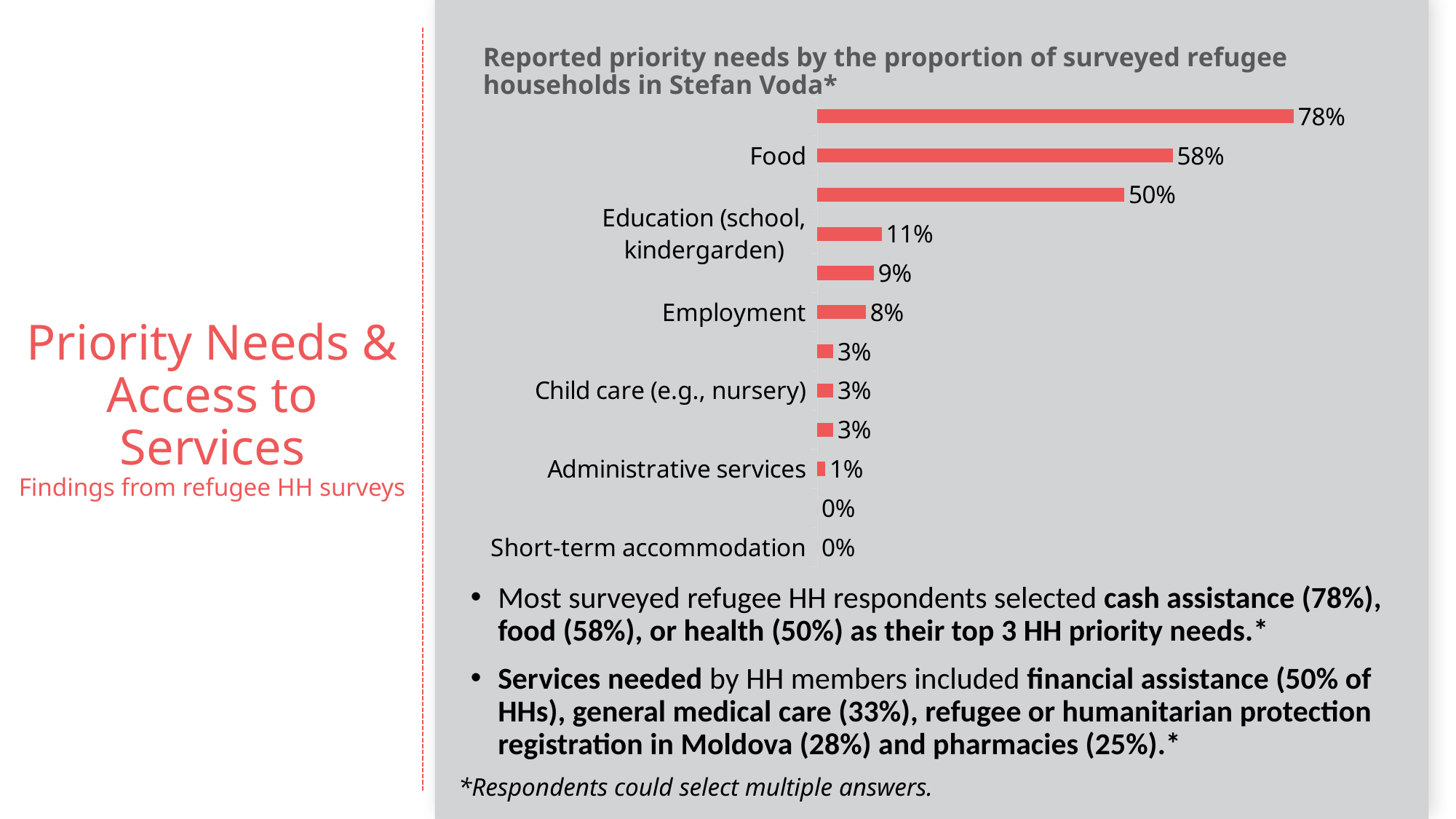
What is the value for Child care (e.g., nursery)? 3% What is the value for Administrative services? 1% What is the value for Education (school, kindergarden)? 11% How many bars (categories) are plotted in the chart? 12 What proportion of households reported Employment as a priority need? 8% What is the difference between the values for Food and Education (school, kindergarden)? 47 percentage points What proportion of surveyed refugee households reported Food as a priority need? 58% What is the highest value shown on the chart? 78% Which has a larger value, Employment or Child care (e.g., nursery)? Employment What is the value for Short-term accommodation? 0% What kind of chart is shown on the slide? Bar chart What is the title of the chart? Reported priority needs by the proportion of surveyed refugee households in Stefan Voda*